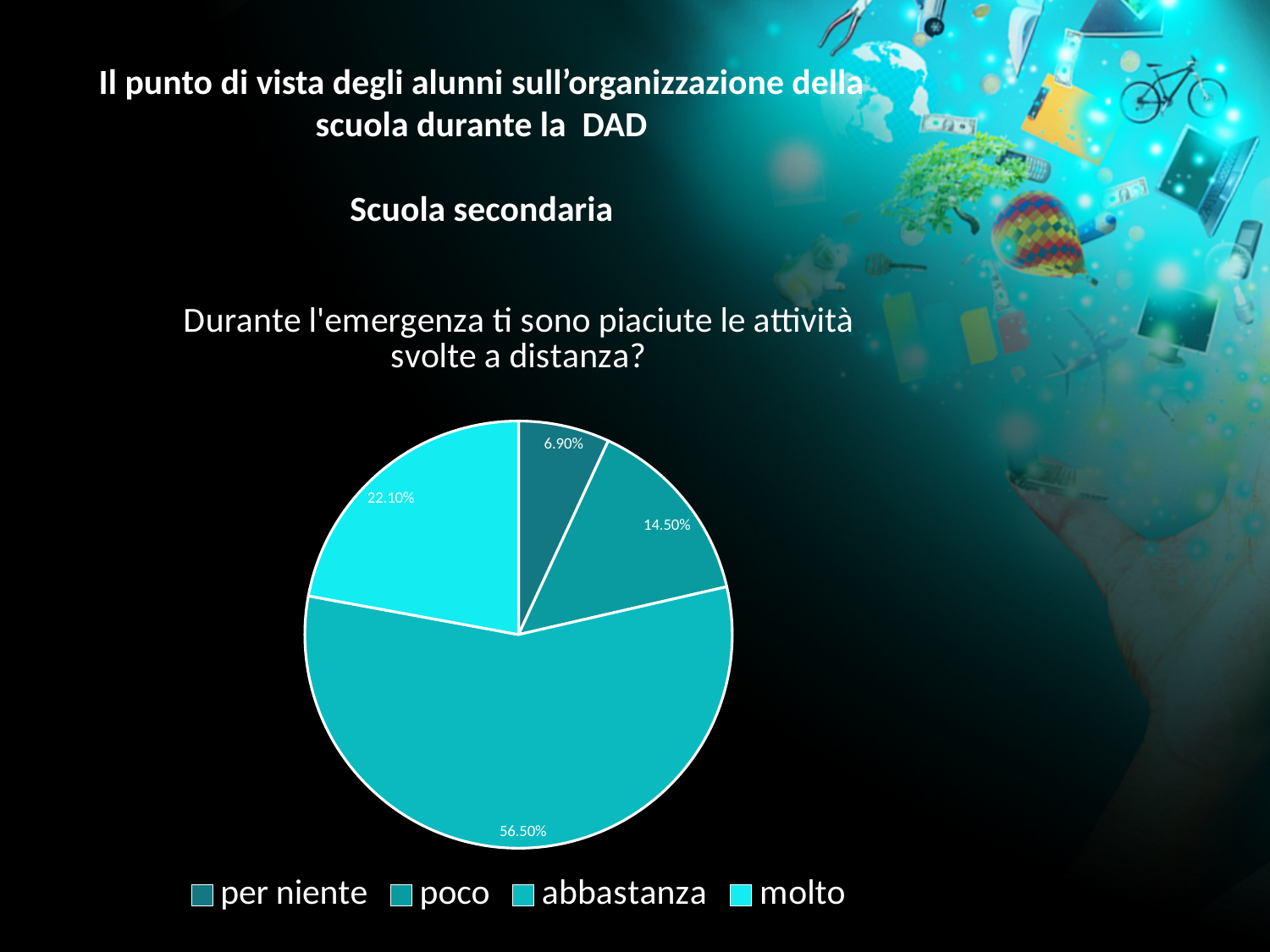
Which category has the largest slice of the pie? abbastanza What percentage of the pie is the 'per niente' slice? 6.90% What is the difference in percentage points between the 'abbastanza' and 'molto' slices? 34.40% What percentage of the pie is the 'abbastanza' slice? 56.50% What kind of chart is shown on the slide? pie chart What percentage of the pie is the 'molto' slice? 22.10% Which slice is larger, 'molto' or 'poco'? molto How many categories does the legend list? 4 What is the chart's title? Durante l'emergenza ti sono piaciute le attività svolte a distanza? What percentage of the pie is the 'poco' slice? 14.50% What is the combined share of the 'per niente' and 'poco' slices? 21.40% Which category has the smallest slice of the pie? per niente